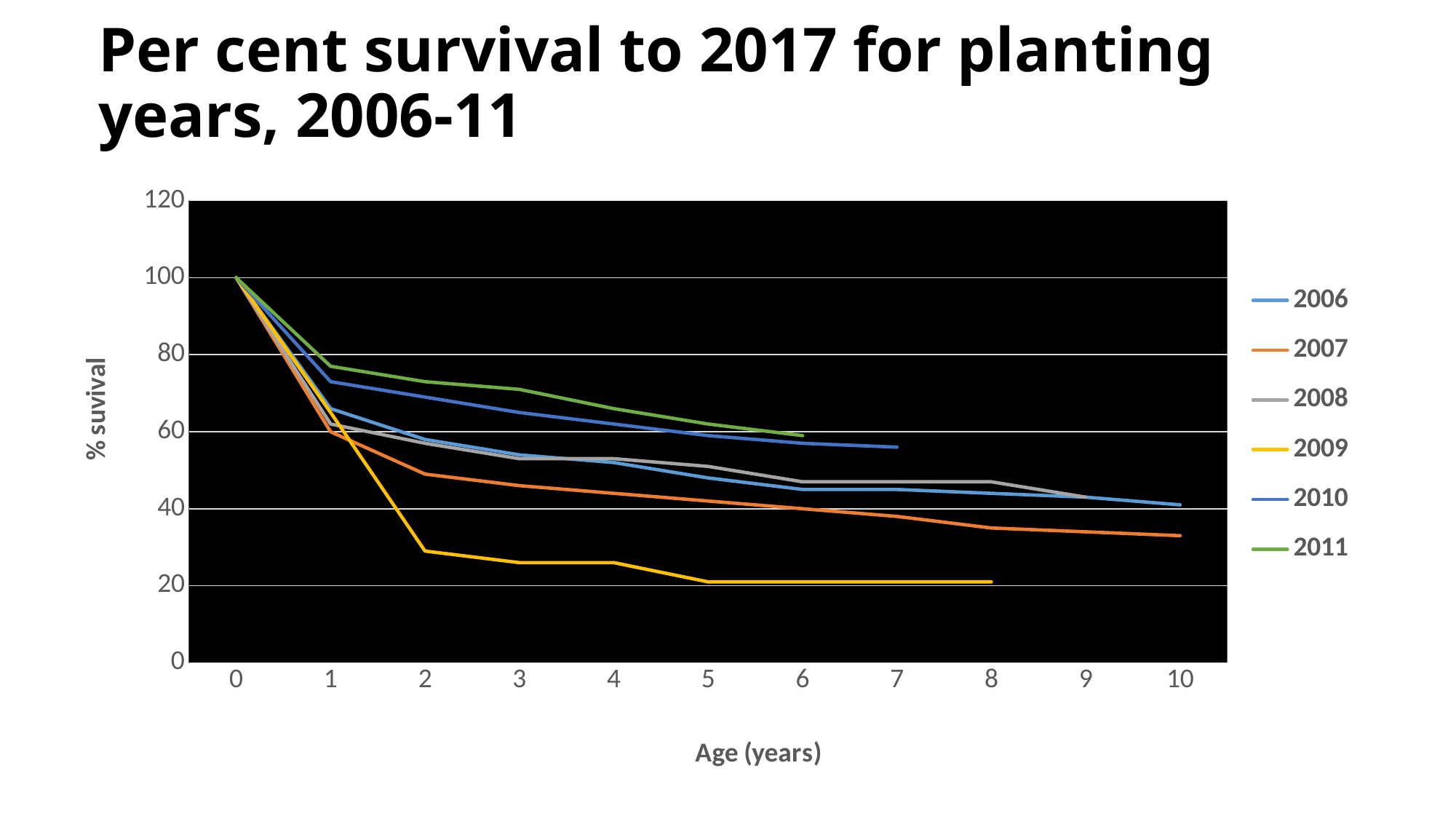
Which planting year has the highest per cent survival at age 5? 2011 Is the value for the 2009 planting year at age 2 greater or less than 40? less Do the per cent survival values rise or fall as age increases? fall Is the value for the 2007 planting year at age 10 greater or less than 40? less Is the value for the 2008 planting year at age 8 greater or less than 40? greater Which planting year has the lowest per cent survival at age 5? 2009 What kind of chart is shown on the slide? line chart How many series does the legend list? 6 At age 6, which planting year has the higher per cent survival, 2010 or 2006? 2010 What is the per cent survival for the 2006 planting year at age 0? 100 What is the label on the x axis of the chart? Age (years)